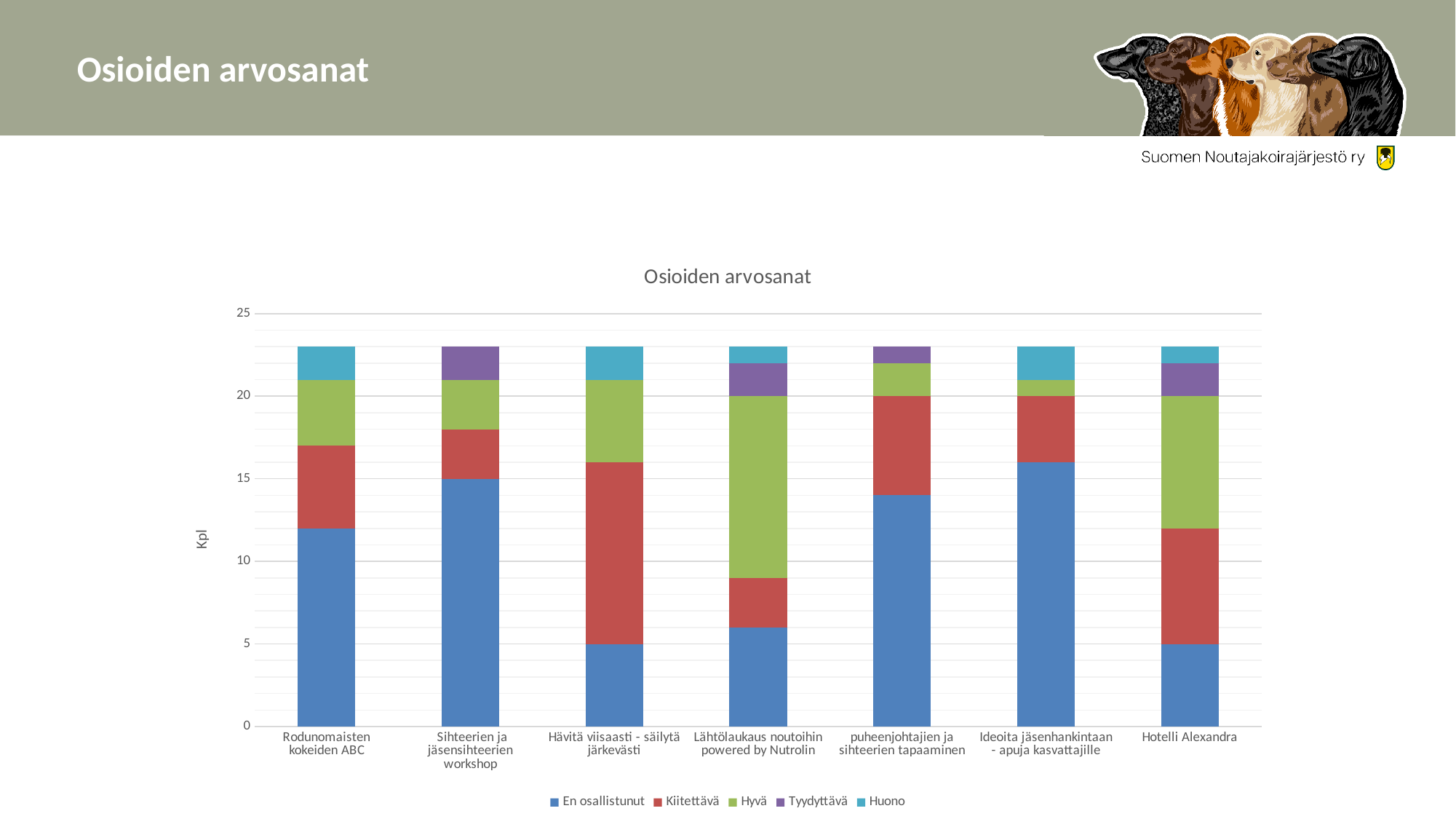
How many categories are shown along the x axis of the chart? 7 Which category has the largest 'Kiitettävä' segment? Hävitä viisaasti - säilytä järkevästi How many series does the legend of the chart list? 5 Is the total height of the stacked bar for 'Hotelli Alexandra' greater or less than 20? greater Which has the larger 'En osallistunut' value: 'Rodunomaisten kokeiden ABC' or 'Lähtölaukaus noutoihin powered by Nutrolin'? Rodunomaisten kokeiden ABC What is the title of the chart? Osioiden arvosanat Is the 'En osallistunut' value for 'Ideoita jäsenhankintaan - apuja kasvattajille' greater or less than 15? greater Which category has the largest 'Hyvä' segment? Lähtölaukaus noutoihin powered by Nutrolin Is the 'En osallistunut' value for 'Lähtölaukaus noutoihin powered by Nutrolin' greater or less than 10? less What kind of chart is shown on the slide? stacked bar chart What is the label on the y axis of the chart? Kpl